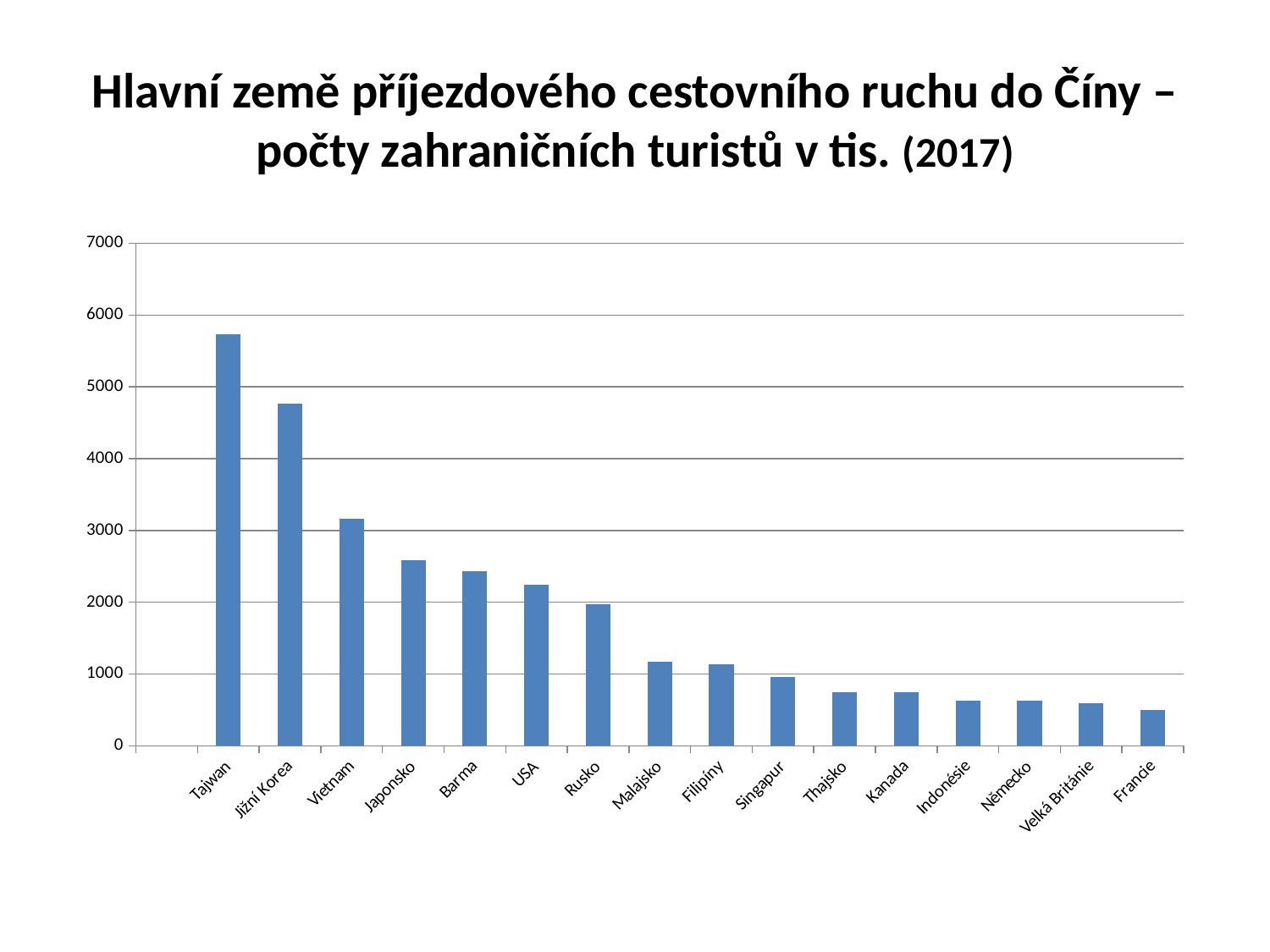
Which country has the lowest number of tourists in the chart? Francie Is the value for Jižní Korea greater or less than 5000? less Which country has the highest number of tourists in the chart? Tajwan What year is given in the chart title? 2017 What kind of chart is shown on the slide? bar chart Do the values rise or fall from left to right along the x axis? fall Is the value for Malajsko greater or less than 1000? greater Is the value for Tajwan greater or less than 5000? greater How many countries are shown on the x axis of the chart? 16 Which has a larger value, Vietnam or Japonsko? Vietnam